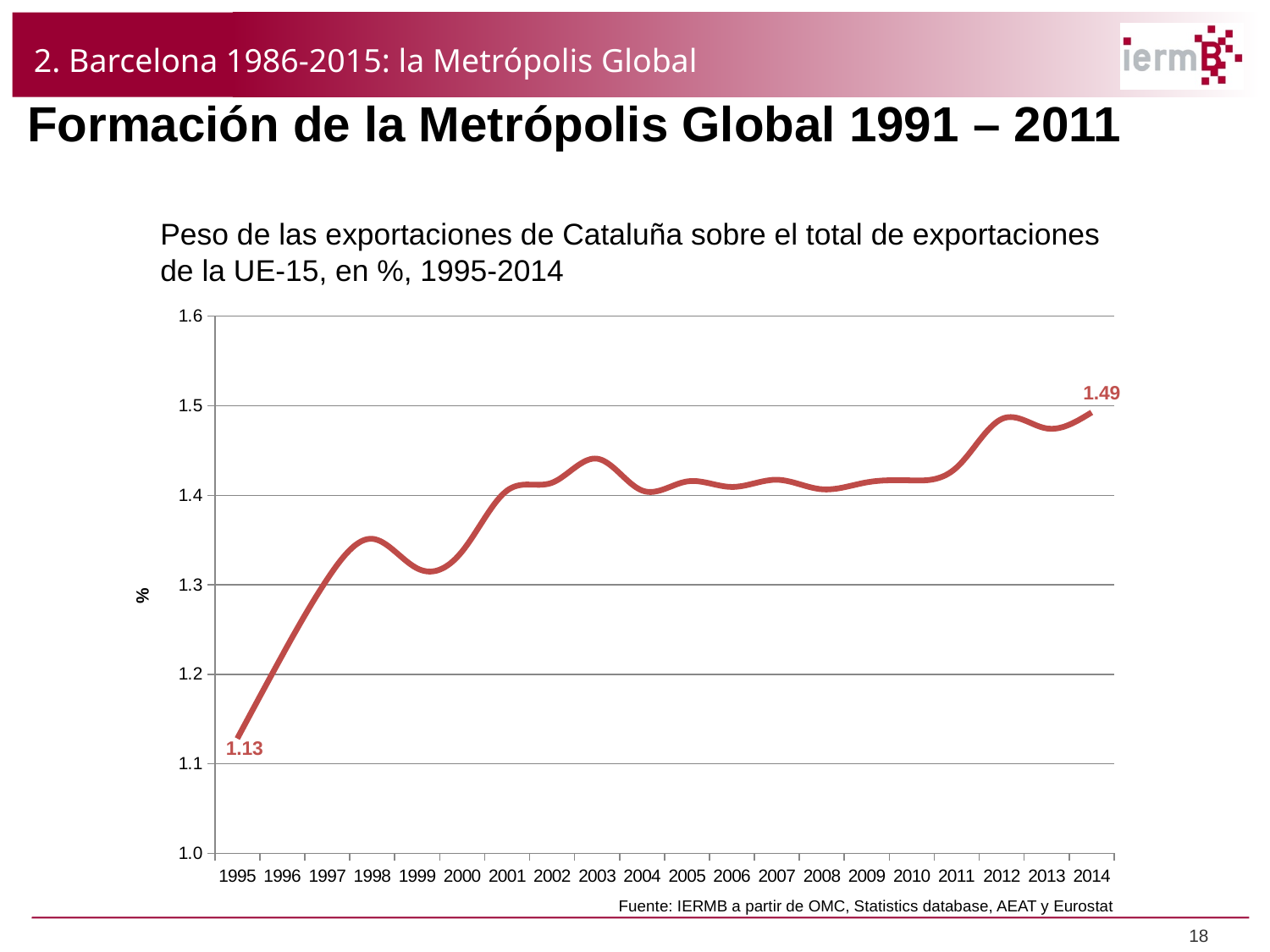
Is the value for 1999 greater or less than 1.4? less By how much did the labelled value increase from 1995 to 2014? 0.36 Which year has the larger value, 2003 or 2004? 2003 How many years are shown on the x axis of the chart? 20 What value is labelled for 1995 on the chart? 1.13 What is the label on the y axis of the chart? % What kind of chart is shown on the slide? line chart Overall, does the line rise or fall from 1995 to 2014? rise Is the value for 2003 greater or less than 1.4? greater What value is labelled for 2014 on the chart? 1.49 Is the value for 2008 greater or less than 1.5? less Which year has the lowest value on the chart? 1995